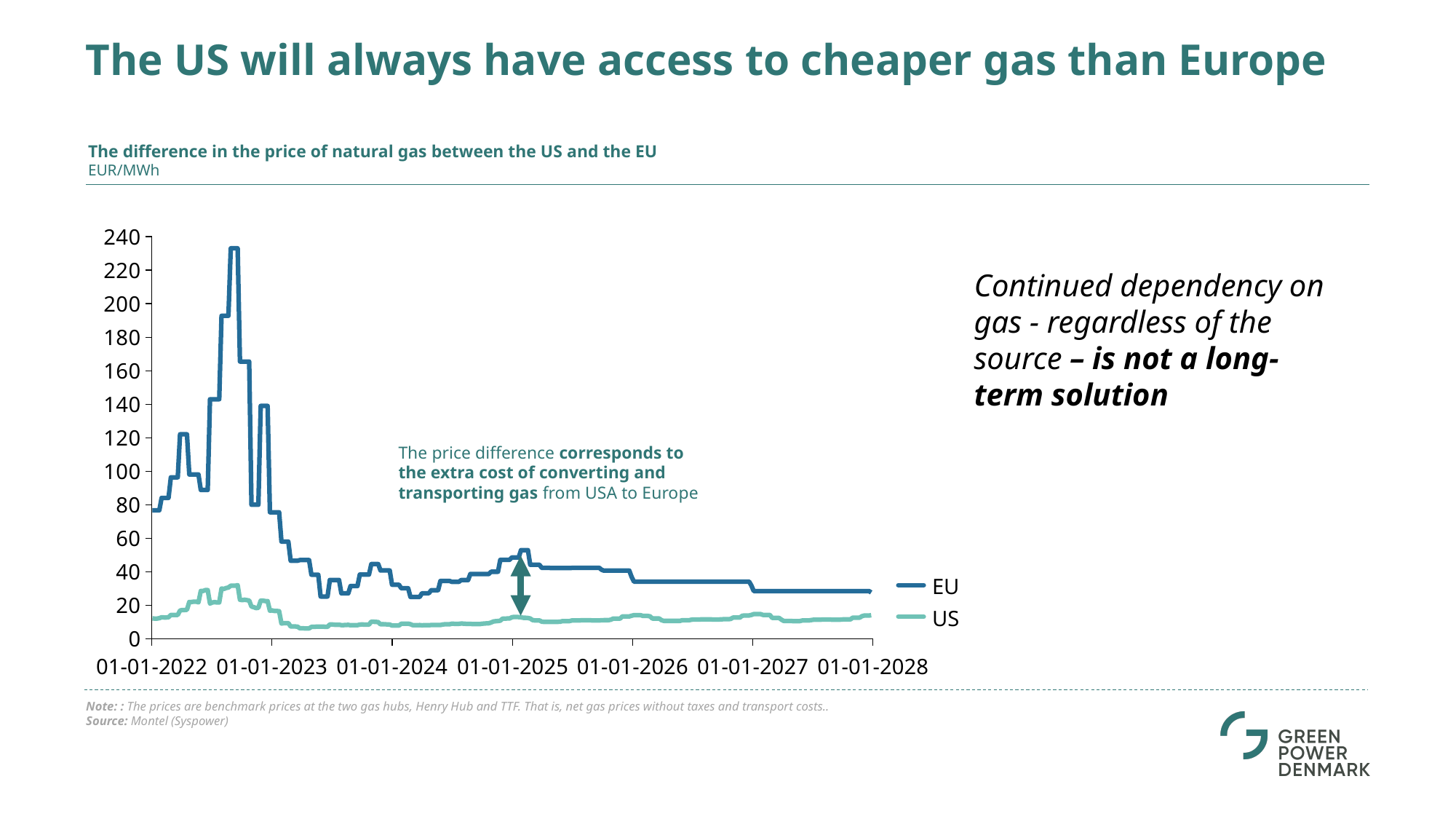
Does the EU series reach its highest value before or after 01-01-2023? before Which series, EU or US, has the higher values across the whole period? EU What unit is the chart measured in? EUR/MWh Is the EU value at 01-01-2028 greater or less than 40? less Is the peak value of the US series greater or less than 40? less What are the two series named in the legend? EU and US How many series does the legend list? 2 Does the EU series rise or fall between 01-01-2026 and 01-01-2028? fall What kind of chart is shown on the slide? line chart Is the EU value at 01-01-2022 greater or less than 60? greater